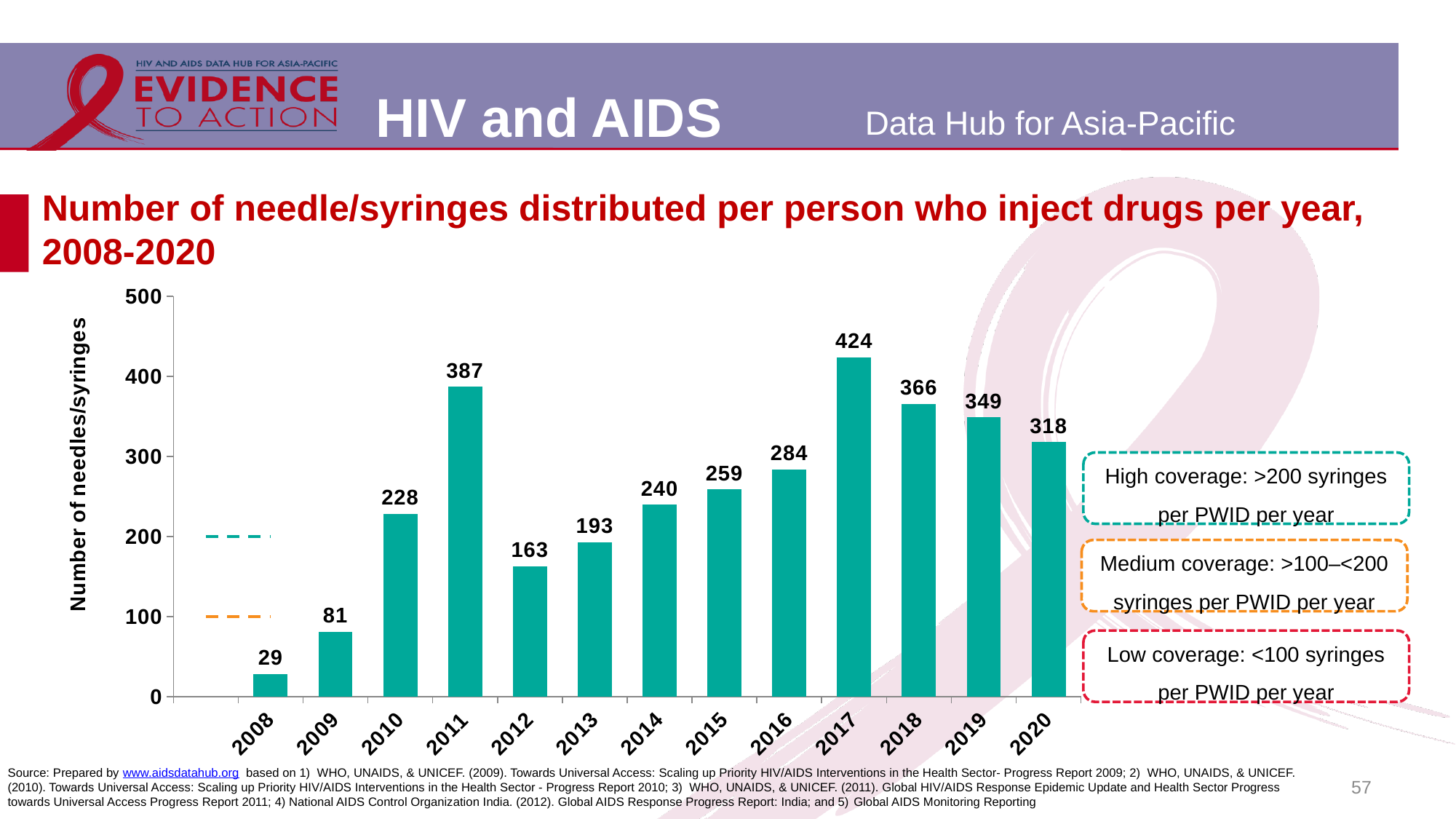
Which year has the highest number of needles/syringes distributed per person? 2017 What is the value shown for 2020? 318 What is the difference between the values for 2017 and 2018? 58 Which year has a larger value, 2012 or 2013? 2013 Which year has the lowest number of needles/syringes distributed per person? 2008 What is the value shown for 2008? 29 How many years are shown on the x axis of the chart? 13 Do the values rise or fall from 2017 to 2020? Fall What kind of chart is shown on the slide? Bar chart What is the number of needles/syringes distributed per person who injects drugs in 2011? 387 What is the label of the y axis of the chart? Number of needles/syringes Is the value for 2016 greater or less than 300? less